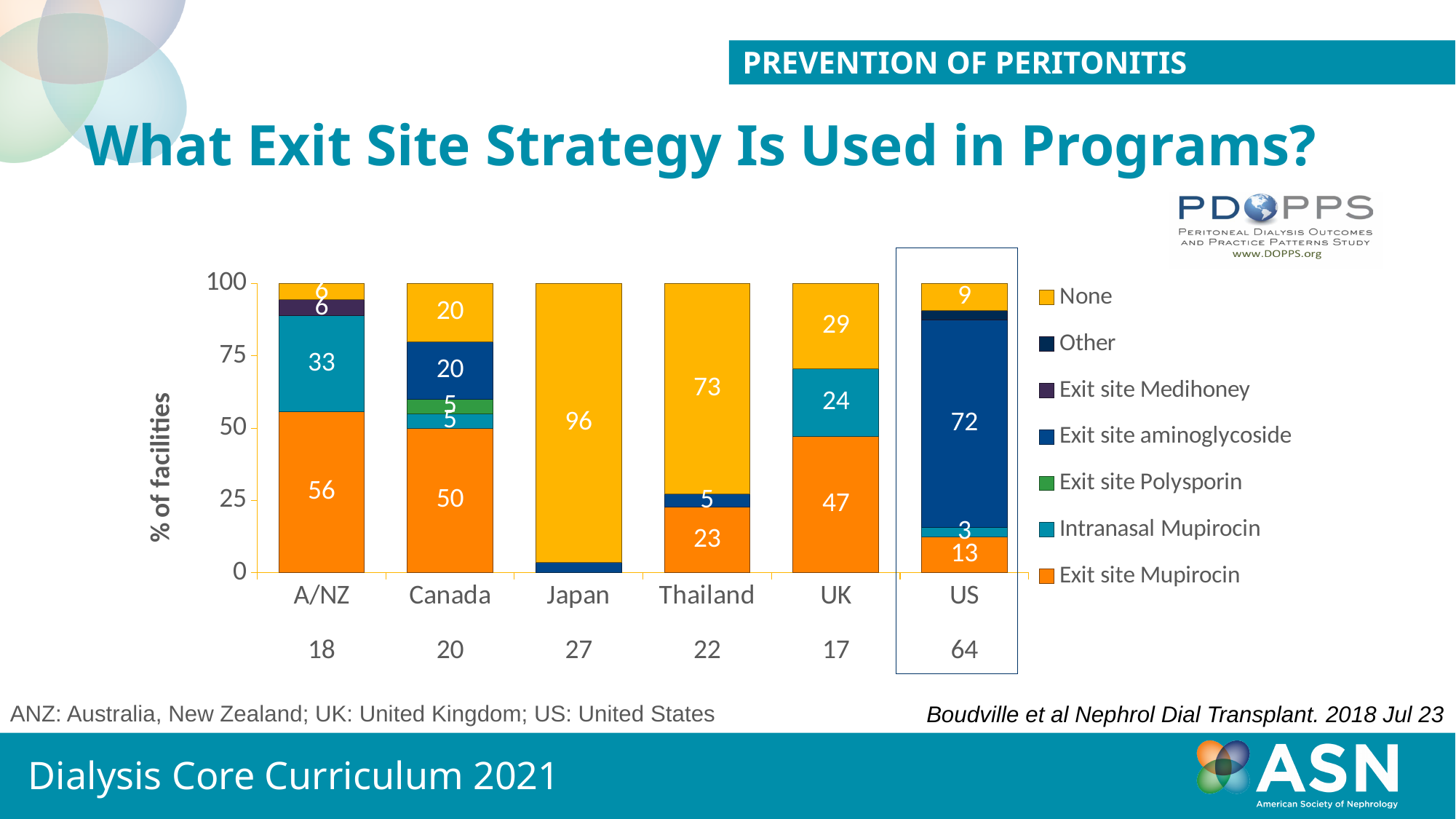
What is the value for None in Japan? 96 Which has a larger Intranasal Mupirocin value, A/NZ or the UK? A/NZ What is the difference between the None value for Thailand and the None value for the UK? 44 Which country has the highest value for None? Japan Which country has the highest value for Exit site Mupirocin? A/NZ How many countries or regions are shown on the x axis? 6 What percentage of facilities in A/NZ use Exit site Mupirocin? 56 In the US, how much larger is the Exit site aminoglycoside value than the Exit site Mupirocin value? 59 What percentage of US facilities use Exit site aminoglycoside? 72 What kind of chart is shown on the slide? Stacked bar chart What is the value for Exit site Mupirocin in Thailand? 23 How many series does the legend list? 7